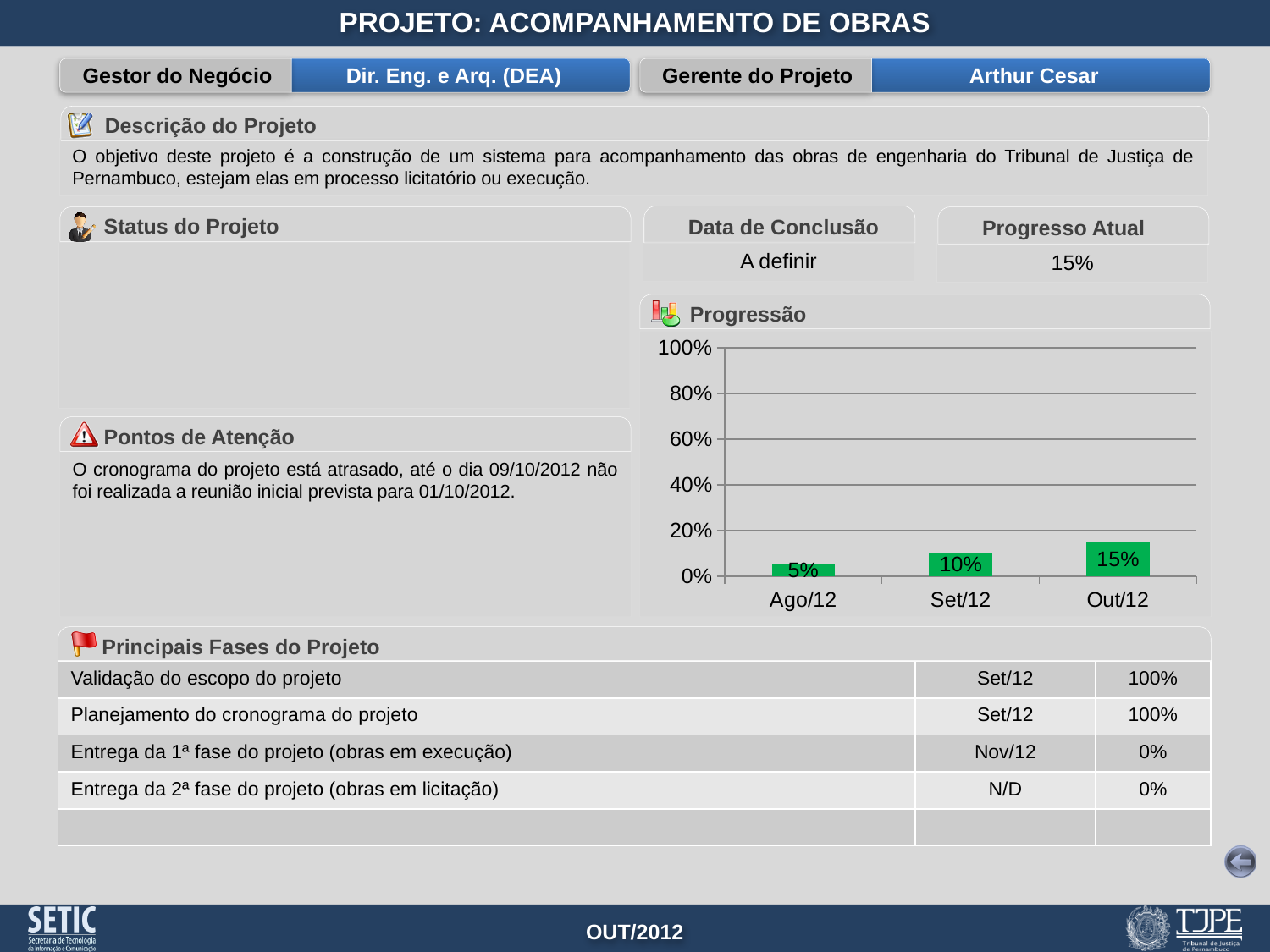
How many months are shown on the x axis of the Progressão chart? 3 What is the difference between the values for Out/12 and Ago/12 in the Progressão chart? 10% Do the values in the Progressão chart rise or fall from Ago/12 to Out/12? rise Is the value for Out/12 in the Progressão chart greater or less than 20%? less What is the difference between the values for Set/12 and Ago/12 in the Progressão chart? 5% What is the value for Ago/12 in the Progressão chart? 5% Which month has the lowest value in the Progressão chart? Ago/12 Which is larger in the Progressão chart, the value for Set/12 or the value for Out/12? Out/12 What is the value for Out/12 in the Progressão chart? 15% What is the value for Set/12 in the Progressão chart? 10% What kind of chart is the Progressão chart? bar chart Which month has the highest value in the Progressão chart? Out/12